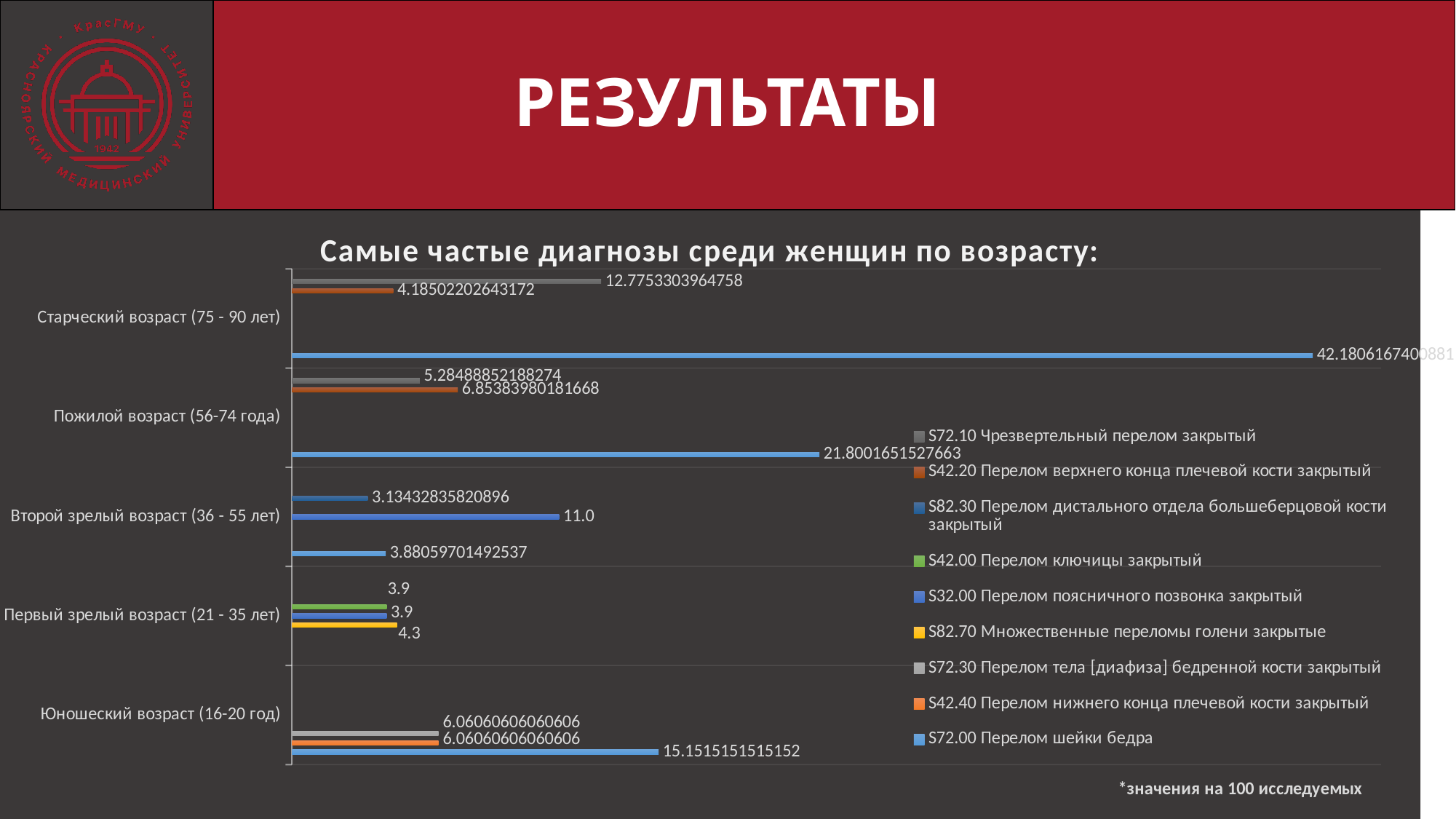
What is the title of the chart? Самые частые диагнозы среди женщин по возрасту: Which age category has the highest value on the chart? Старческий возраст (75 - 90 лет) What is the value of the longest bar for Юношеский возраст (16-20 год)? 15.1515151515152 What kind of chart is shown on the slide? bar chart How many age categories are shown on the chart? 5 What is the value of the longest bar for Старческий возраст (75 - 90 лет)? 42.1806167400881 How many series does the legend list? 9 What is the value of the yellow bar (S82.70 Множественные переломы голени закрытые) for Первый зрелый возраст (21 - 35 лет)? 4.3 What is the smallest labelled value on the chart? 3.13432835820896 What is the value of the longest bar for Пожилой возраст (56-74 года)? 21.8001651527663 What is the difference between the yellow bar (4.3) and the green bar (3.9) for Первый зрелый возраст (21 - 35 лет)? 0.4 What is the value of the green bar (S42.00 Перелом ключицы закрытый) for Первый зрелый возраст (21 - 35 лет)? 3.9